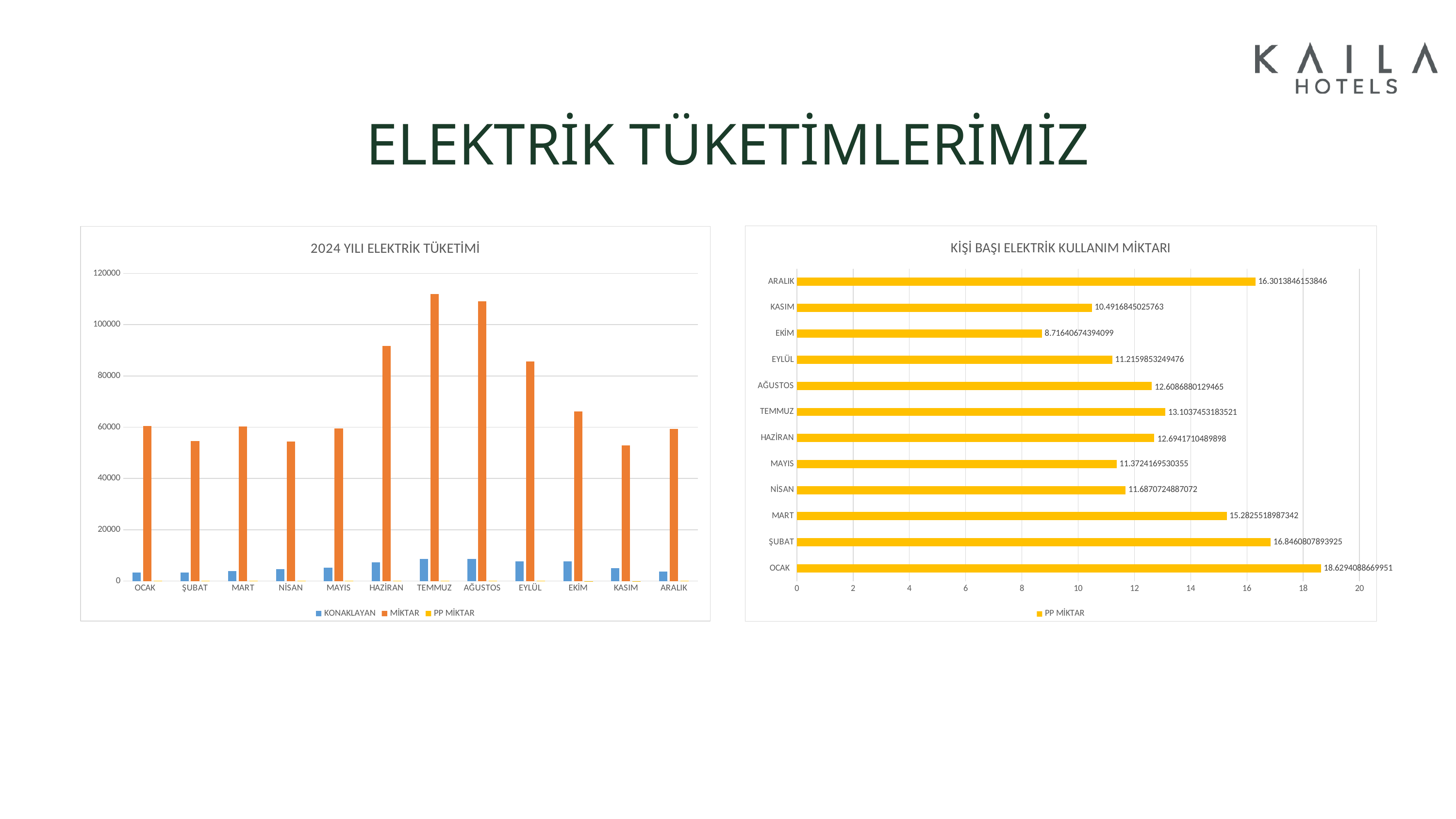
On the chart titled 'KİŞİ BAŞI ELEKTRİK KULLANIM MİKTARI', what is the value for OCAK? 18.6294088669951 On the chart titled 'KİŞİ BAŞI ELEKTRİK KULLANIM MİKTARI', which is larger, the value for ŞUBAT or the value for MART? ŞUBAT On the chart titled 'KİŞİ BAŞI ELEKTRİK KULLANIM MİKTARI', how many months are shown? 12 On the chart titled 'KİŞİ BAŞI ELEKTRİK KULLANIM MİKTARI', what is the value for TEMMUZ? 13.1037453183521 On the chart titled '2024 YILI ELEKTRİK TÜKETİMİ', is the MİKTAR value for HAZİRAN greater or less than 80000? greater On the chart titled 'KİŞİ BAŞI ELEKTRİK KULLANIM MİKTARI', what is the value for EKİM? 8.71640674394099 On the chart titled 'KİŞİ BAŞI ELEKTRİK KULLANIM MİKTARI', which month has the lowest value? EKİM On the chart titled '2024 YILI ELEKTRİK TÜKETİMİ', which month has the highest MİKTAR value? TEMMUZ What kind of chart is the chart titled '2024 YILI ELEKTRİK TÜKETİMİ'? bar chart On the chart titled 'KİŞİ BAŞI ELEKTRİK KULLANIM MİKTARI', which month has the highest value? OCAK On the chart titled '2024 YILI ELEKTRİK TÜKETİMİ', is the MİKTAR value for KASIM greater or less than 60000? less On the chart titled '2024 YILI ELEKTRİK TÜKETİMİ', how many series does the legend list? 3